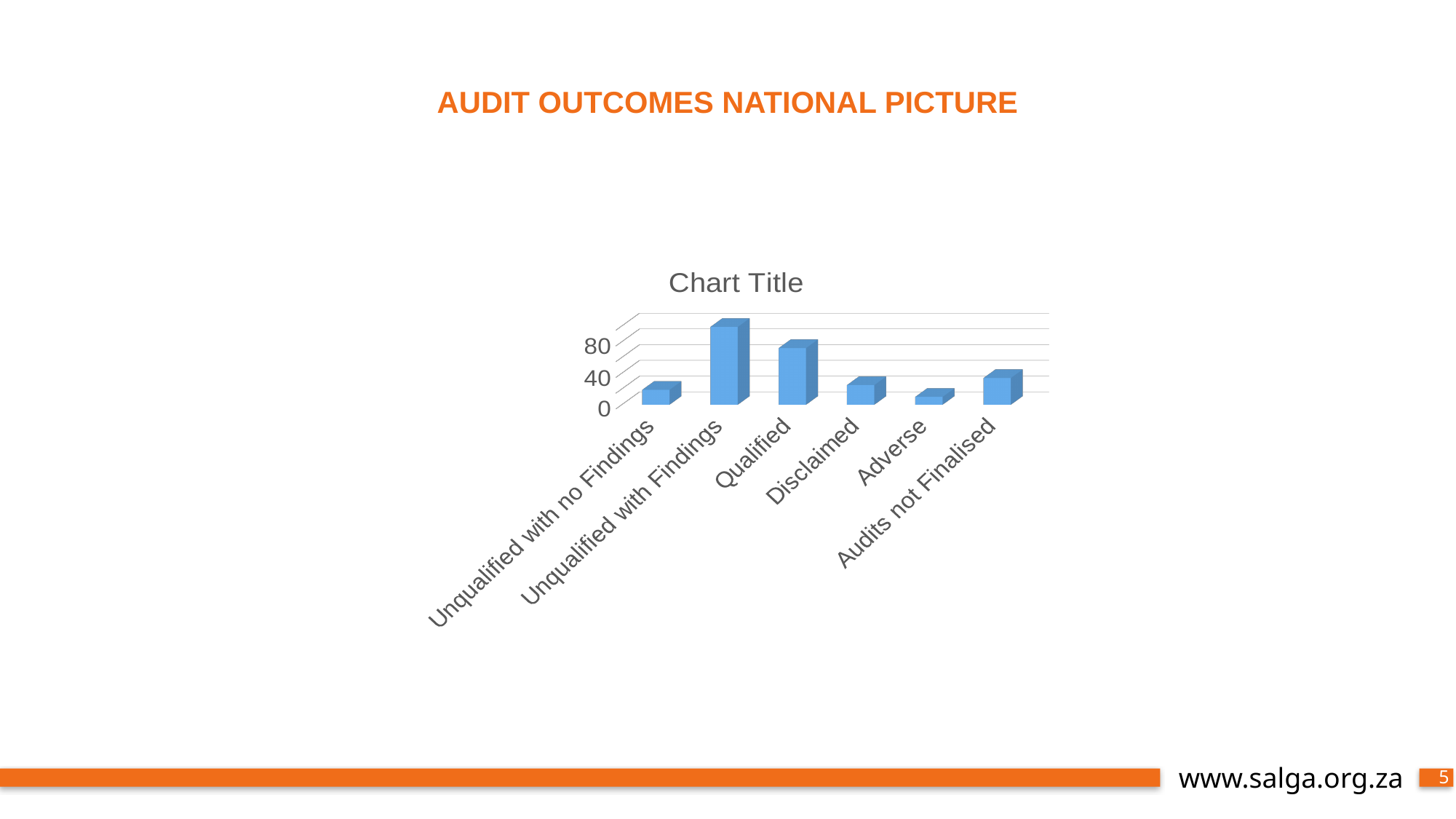
Is the value for Unqualified with no Findings greater or less than 40? less What is the title shown above the chart? Chart Title What is the title of the slide containing the chart? AUDIT OUTCOMES NATIONAL PICTURE What kind of chart is shown on the slide? Bar chart Which category has the highest value on the chart? Unqualified with Findings How many categories are plotted on the chart? 6 Which category has the lowest value on the chart? Adverse Is the value for Unqualified with Findings greater or less than 80? greater Which is larger, the value for Audits not Finalised or the value for Adverse? Audits not Finalised Is the value for Qualified greater or less than 40? greater Which is larger, the value for Qualified or the value for Disclaimed? Qualified